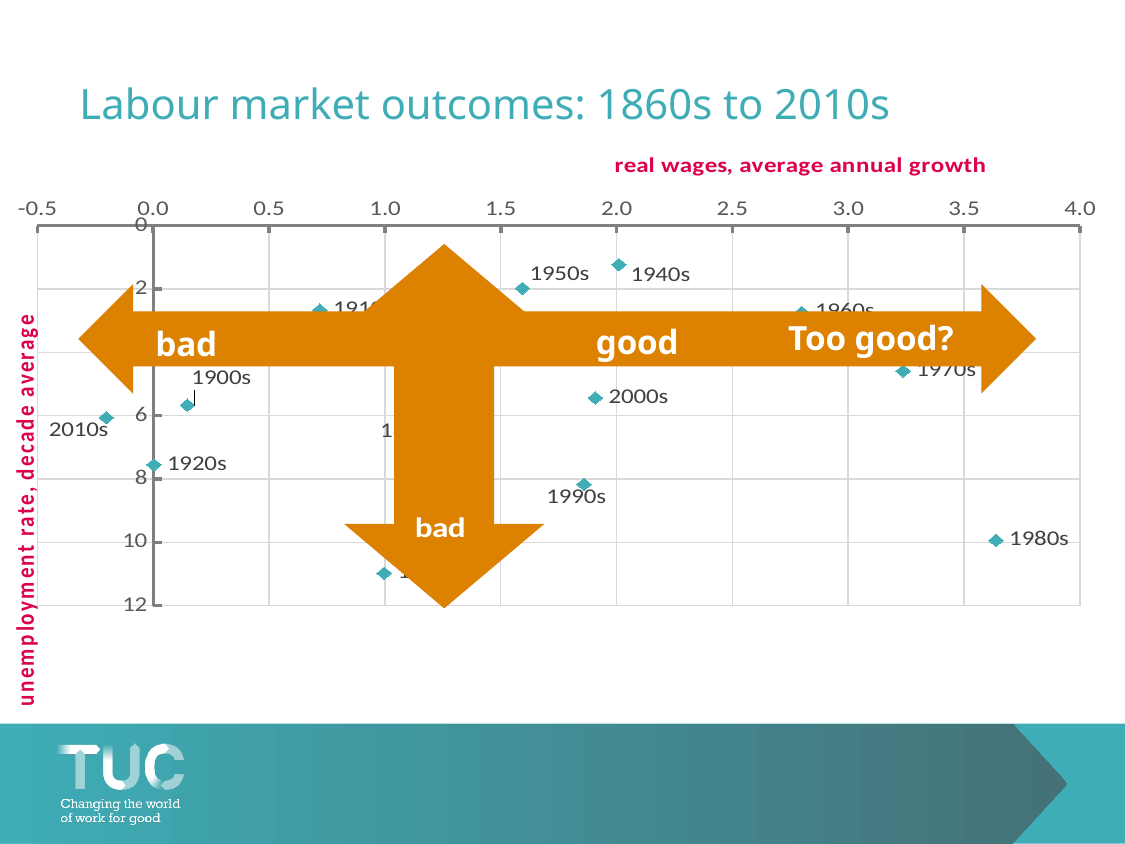
What does the horizontal axis of the chart measure? real wages, average annual growth Which labelled decade has the lowest real wage growth? 2010s Which labelled decade has the highest real wage growth? 1980s What kind of chart is shown on the slide? Scatter chart Is the real wage growth for the 1960s greater or less than 2.5? greater Is the unemployment rate for the 1990s greater or less than 6? greater Is the unemployment rate for the 1940s greater or less than 2? less What is the title of the chart? Labour market outcomes: 1860s to 2010s Which decade has a higher unemployment rate, the 1980s or the 1970s? 1980s